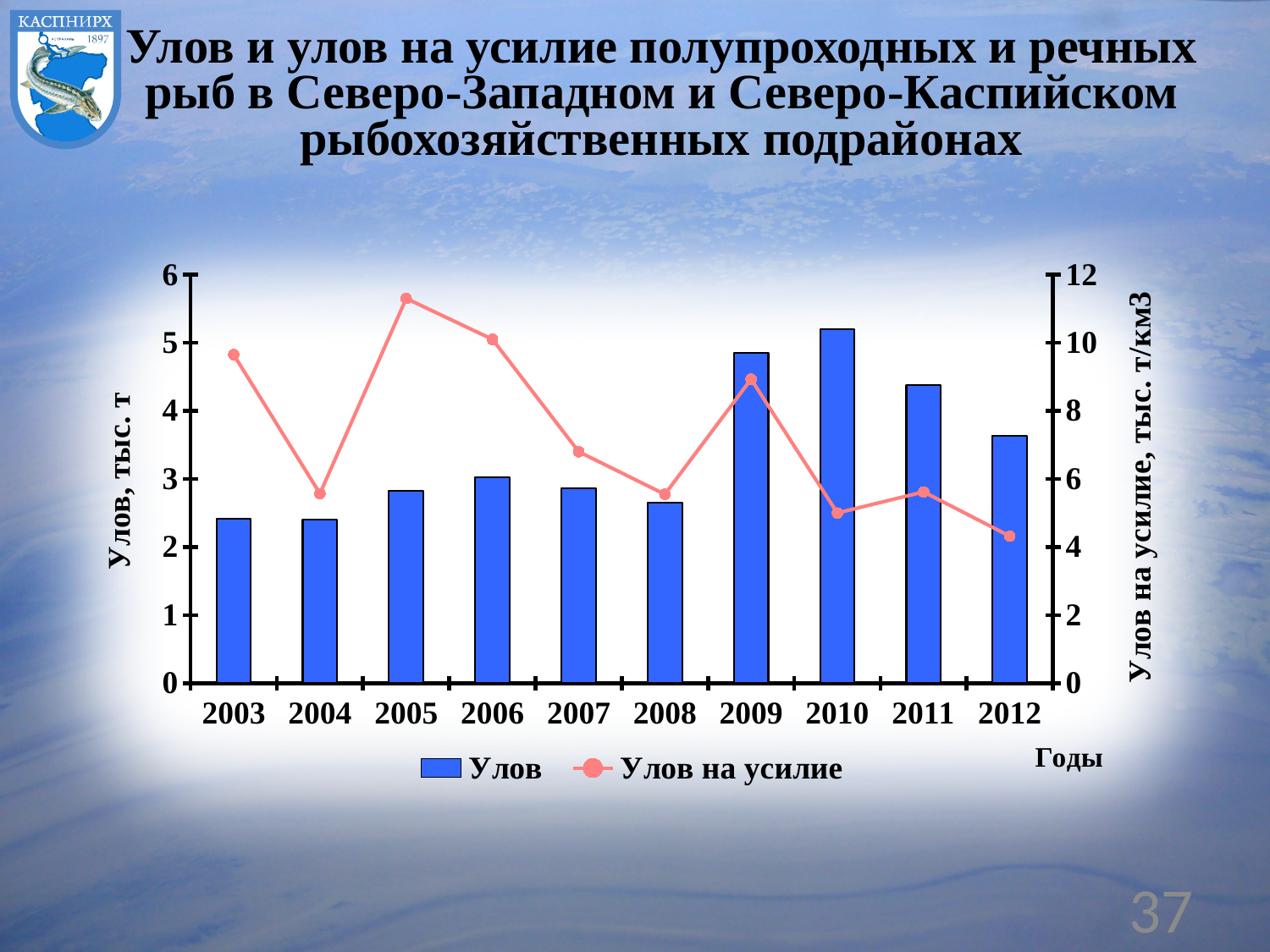
In which year is the bar for Улов the highest? 2010 Is the Улов value for 2010 greater or less than 5? greater How many series does the chart legend list? 2 How many years are shown on the x axis of the chart? 10 In which year does the Улов на усилие line reach its highest point? 2005 Is the Улов на усилие value for 2005 greater or less than 10? greater Is the Улов на усилие value for 2012 greater or less than 5? less Which year has the larger Улов bar, 2009 or 2012? 2009 In which year does the Улов на усилие line reach its lowest point? 2012 What kind of chart is shown on the slide? Combined bar and line chart Do the Улов bars rise or fall from 2010 to 2012? fall